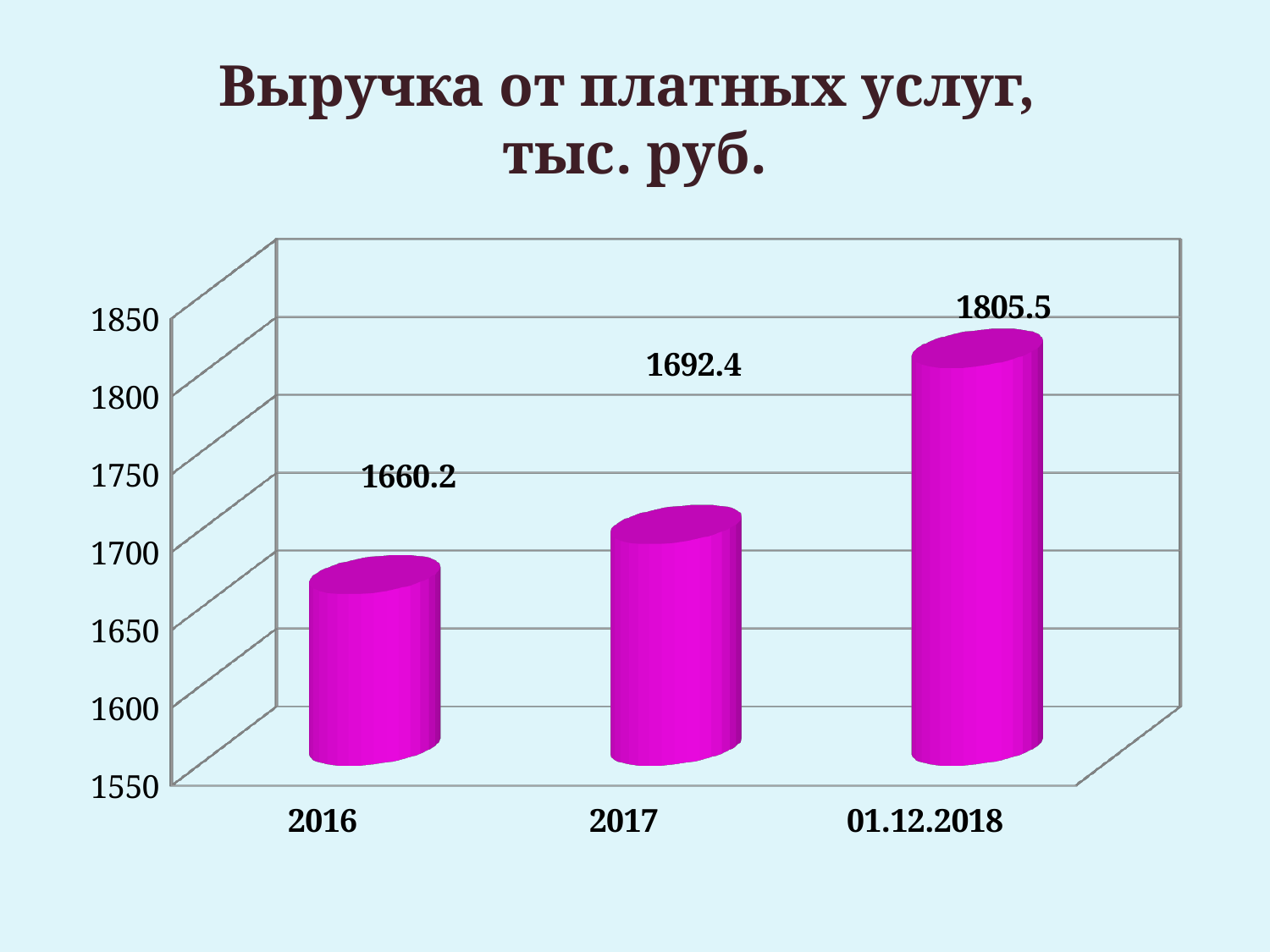
Which is larger, the revenue for 2017 or for 2016? 2017 What is the revenue from paid services for 2016? 1660.2 What is the revenue from paid services for 2017? 1692.4 Do the values rise or fall from 2016 to 01.12.2018? rise What kind of chart is shown on the slide? bar chart How many periods are shown on the chart? 3 What is the revenue from paid services for 01.12.2018? 1805.5 Is the value for 01.12.2018 greater or less than 1800? greater What is the difference in revenue between 01.12.2018 and 2017? 113.1 Which period has the highest revenue from paid services? 01.12.2018 What is the difference in revenue between 2017 and 2016? 32.2 Which period has the lowest revenue from paid services? 2016